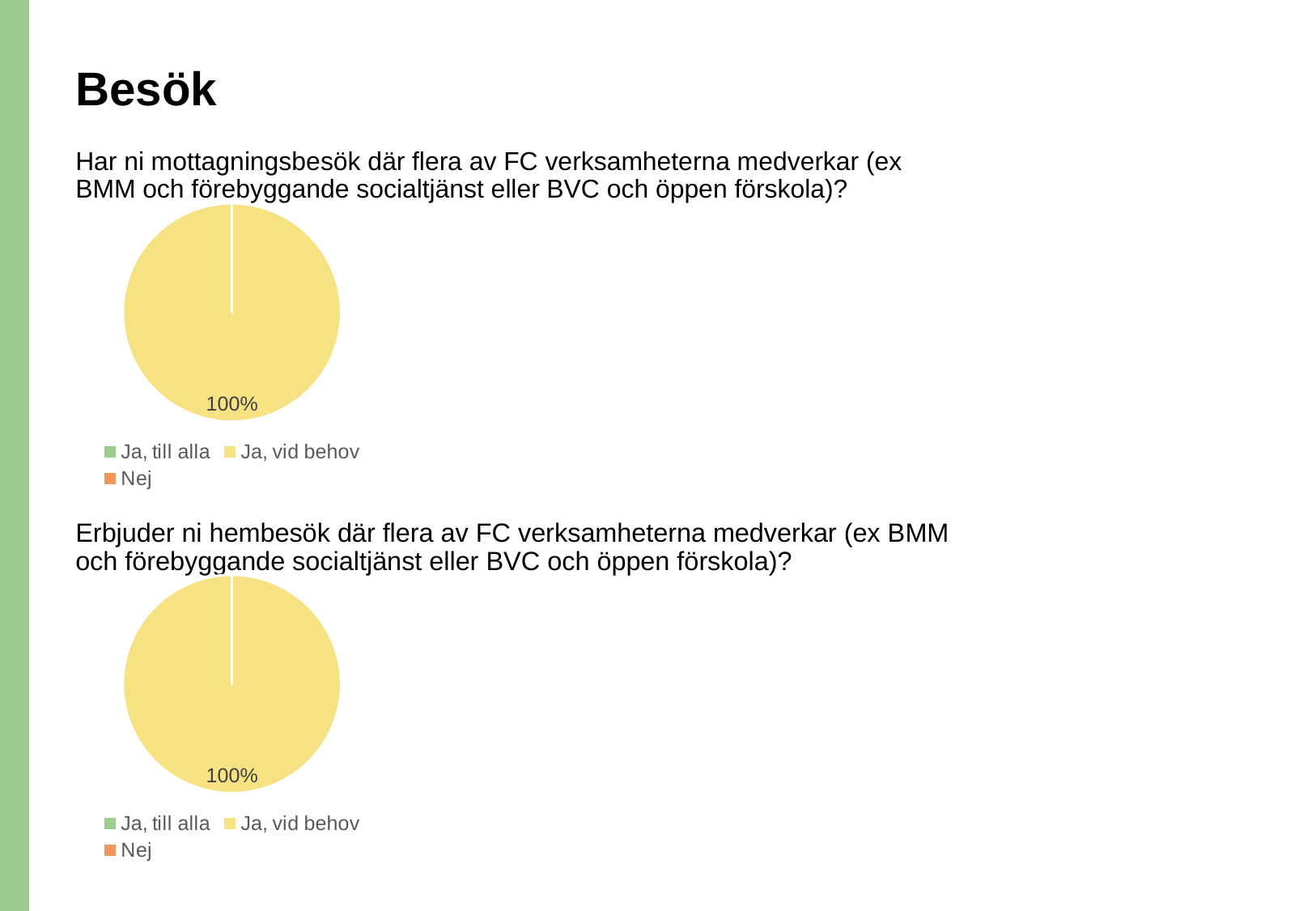
What colour represents "Nej" in the legend of the bottom chart? Orange In the bottom chart (hembesök), what share of the pie does "Ja, vid behov" have? 100% What kind of chart is the bottom chart on the slide? Pie chart In the bottom chart, which category makes up the whole pie? Ja, vid behov What colour represents "Ja, till alla" in the legend of the top chart? Green In the top chart, which category makes up the whole pie? Ja, vid behov How many entries does the legend of the top chart list? 3 In the top chart, is the share for "Ja, vid behov" greater or less than 50%? greater What kind of chart is the top chart on the slide? Pie chart How many entries does the legend of the bottom chart list? 3 In the top chart (mottagningsbesök), what share of the pie does "Ja, vid behov" have? 100%